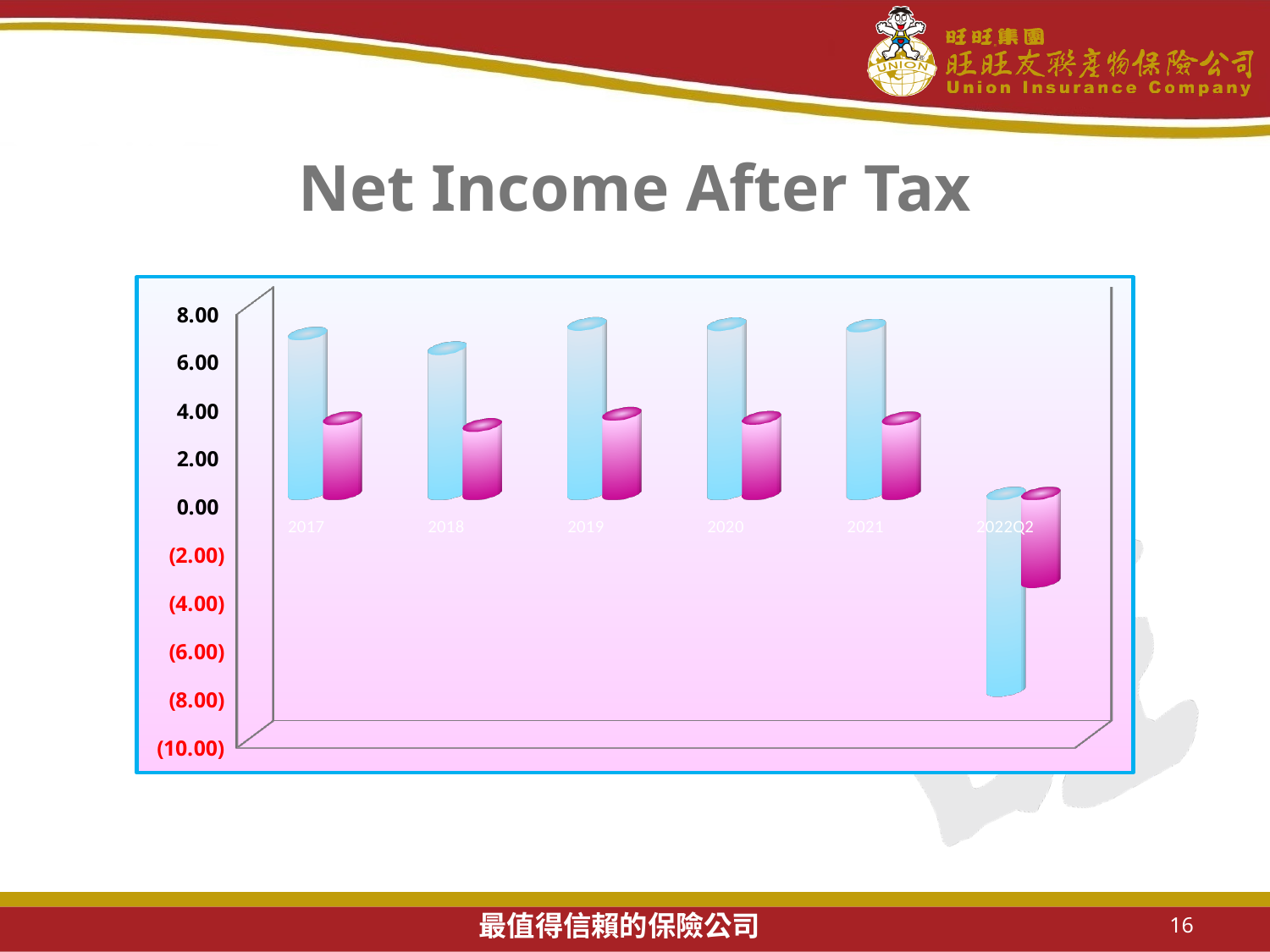
Is the magenta bar for 2017 greater or less than 2.00? greater Is the magenta bar for 2022Q2 greater or less than 0.00? less Is the blue bar for 2017 greater or less than 6.00? greater Which category has the lowest value for the blue series? 2022Q2 How many categories are shown on the x axis of the chart? 6 How many bars are plotted for each category in the chart? 2 In 2019, which is larger, the blue bar or the magenta bar? the blue bar What type of chart is shown on the slide? bar chart Which category has the lowest value for the magenta series? 2022Q2 Does the blue series rise or fall from 2021 to 2022Q2? fall What is the title of the chart? Net Income After Tax